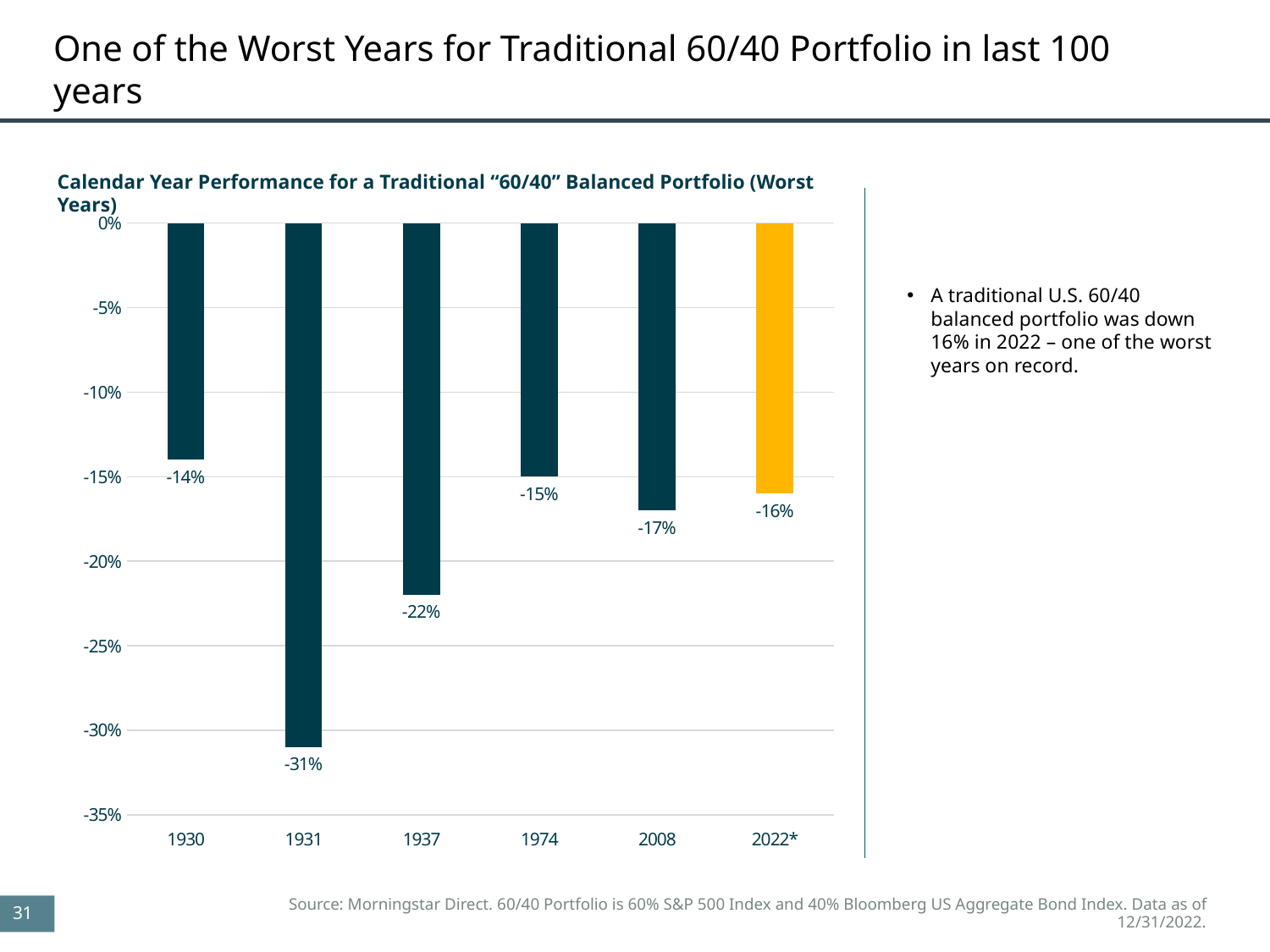
Which year had a worse performance, 2008 or 1974? 2008 What is the difference between the 1931 and 2022* values? 15 percentage points Which year shows the worst (lowest) performance on the chart? 1931 How many years are shown on the chart? 6 What was the calendar year performance of the 60/40 portfolio in 1931? -31% What is the title of the chart? Calendar Year Performance for a Traditional “60/40” Balanced Portfolio (Worst Years) Which year's bar is coloured differently (orange) from the others? 2022* What was the calendar year performance of the 60/40 portfolio in 2022*? -16% What type of chart is shown on the slide? Bar chart What was the calendar year performance of the 60/40 portfolio in 1937? -22% Which year shows the least negative (highest) performance on the chart? 1930 What is the difference between the 1937 and 1930 values? 8 percentage points